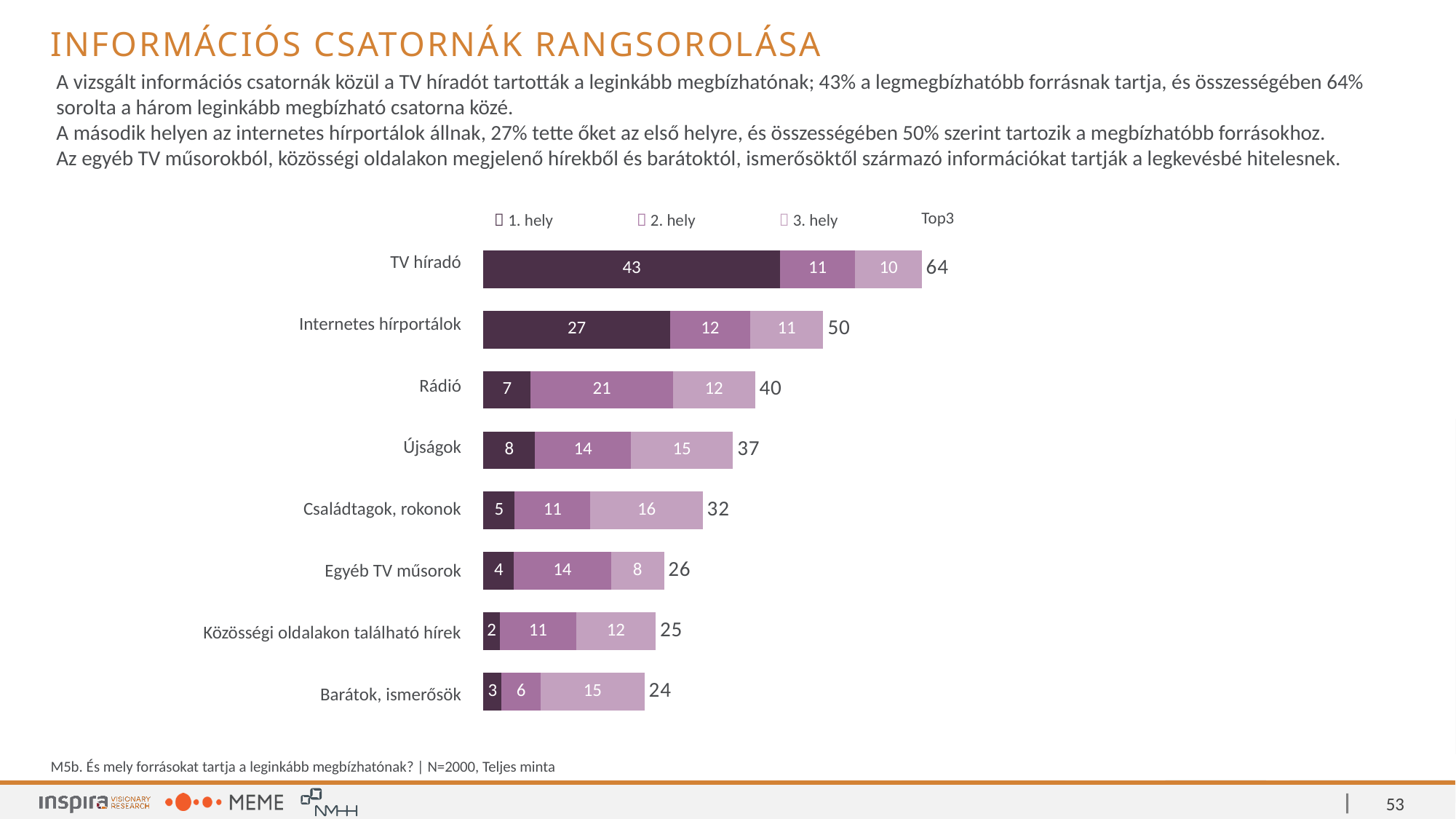
Which category has the highest Top3 value? TV híradó Which category has the lowest Top3 value? Barátok, ismerősök Which has a larger "2. hely" value, Újságok or Barátok, ismerősök? Újságok What is the "2. hely" value for Rádió? 21 What is the Top3 value for Internetes hírportálok? 50 What is the total of the stacked bar for Egyéb TV műsorok? 26 What kind of chart is shown on the slide? Stacked bar chart What is the "1. hely" value for TV híradó? 43 What is the difference between the "1. hely" values for TV híradó and Internetes hírportálok? 16 How many categories are shown in the chart? 8 What is the "3. hely" value for Családtagok, rokonok? 16 How many series does the legend list? 3